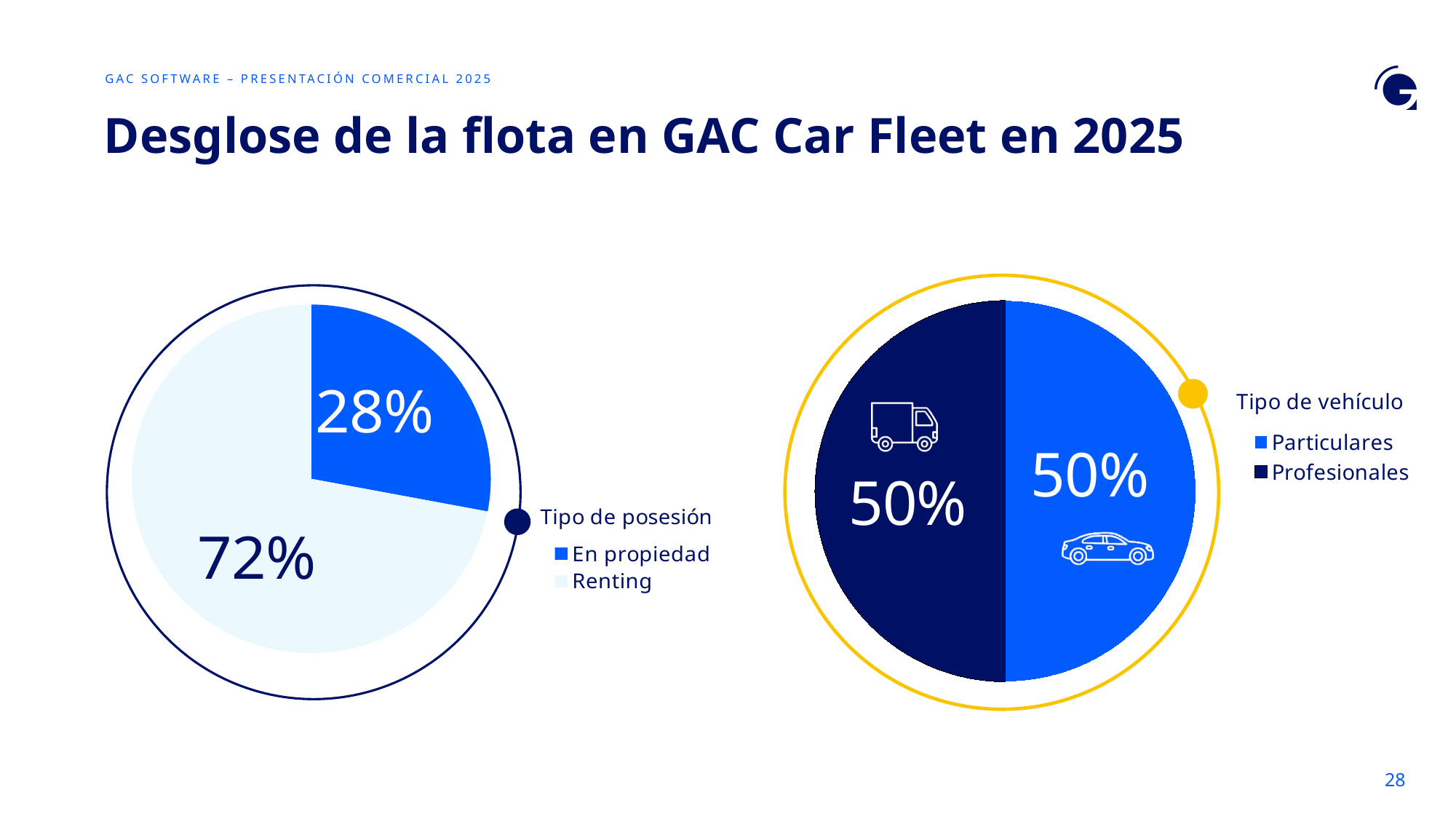
What kind of chart is the 'Tipo de posesión' chart? Pie chart How many entries does the legend of the 'Tipo de posesión' chart list? 2 In the 'Tipo de posesión' chart, what is the difference in percentage points between Renting and En propiedad? 44 In the 'Tipo de posesión' chart, which category has the largest slice? Renting In the 'Tipo de vehículo' chart, what share is labelled for Profesionales? 50% In the 'Tipo de posesión' chart, what share is labelled for Renting? 72% How many categories does the 'Tipo de vehículo' chart show? 2 In the 'Tipo de vehículo' chart, which colour represents Profesionales? Dark navy blue In the 'Tipo de posesión' chart, what share is labelled for En propiedad? 28% In the 'Tipo de vehículo' chart, what share is labelled for Particulares? 50% In the 'Tipo de posesión' chart, which is larger, Renting or En propiedad? Renting In the 'Tipo de posesión' chart, which category has the smallest slice? En propiedad